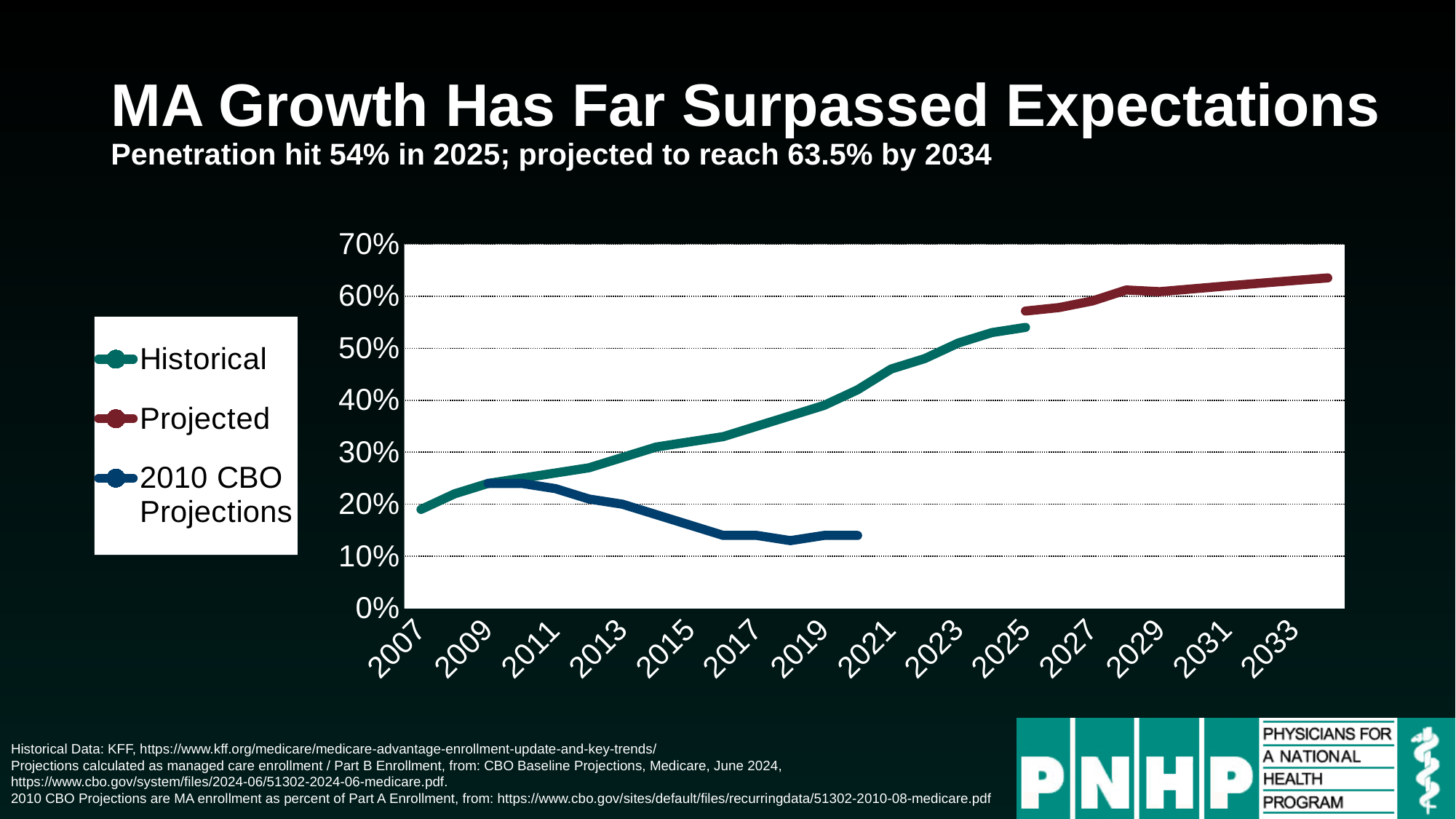
What is the difference between the projected 2034 value (63.5%) and the 2025 historical value (54%)? 9.5% What was the MA penetration value for the Historical series in 2025? 54% Is the Projected value for 2027 greater or less than 50%? greater What value is the Projected series expected to reach by 2034? 63.5% What kind of chart is shown on the slide? line chart What colour is the line for the Projected series? dark red In 2019, which series has the larger value: Historical or 2010 CBO Projections? Historical Does the 2010 CBO Projections series rise or fall from 2009 to 2020? fall How many series does the legend list? 3 Does the Historical series rise or fall from 2007 to 2025? rise Is the 2010 CBO Projections value for 2019 greater or less than 20%? less